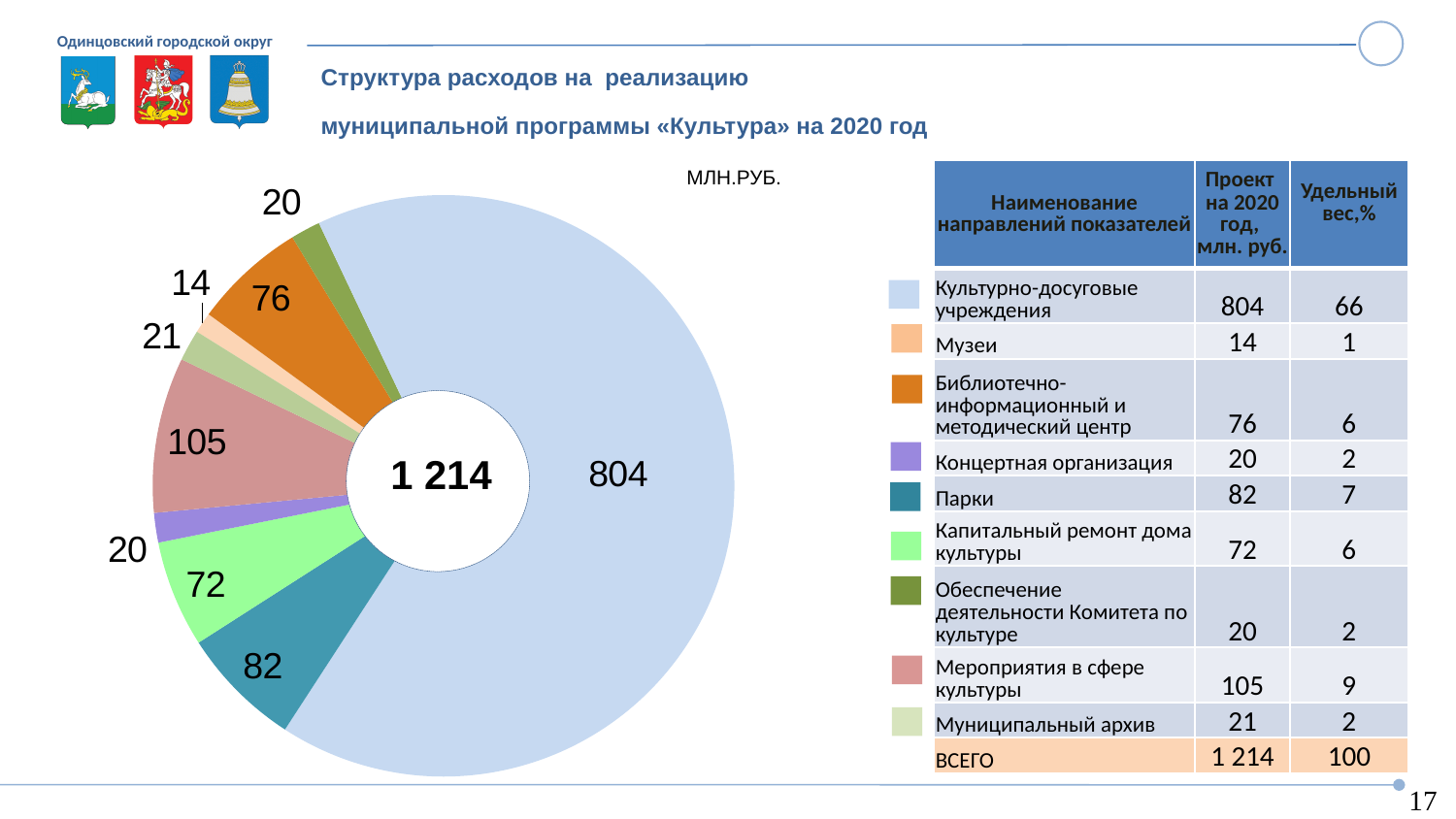
How many slices does the pie chart have? 9 What kind of chart is shown on the slide? Pie (doughnut) chart What is the difference between the values for Культурно-досуговые учреждения and Мероприятия в сфере культуры? 699 Which is larger: the value for Мероприятия в сфере культуры or for Библиотечно-информационный и методический центр? Мероприятия в сфере культуры Which category has the smallest slice of the pie chart? Музеи What total value is shown in the centre of the pie chart? 1 214 What is the value for Культурно-досуговые учреждения on the pie chart? 804 What share (Удельный вес, %) does Культурно-досуговые учреждения have according to the table? 66 Which category has the largest slice of the pie chart? Культурно-досуговые учреждения What is the difference between the values for Мероприятия в сфере культуры and Парки? 23 What is the value for Мероприятия в сфере культуры on the pie chart? 105 What is the value for Парки on the pie chart? 82